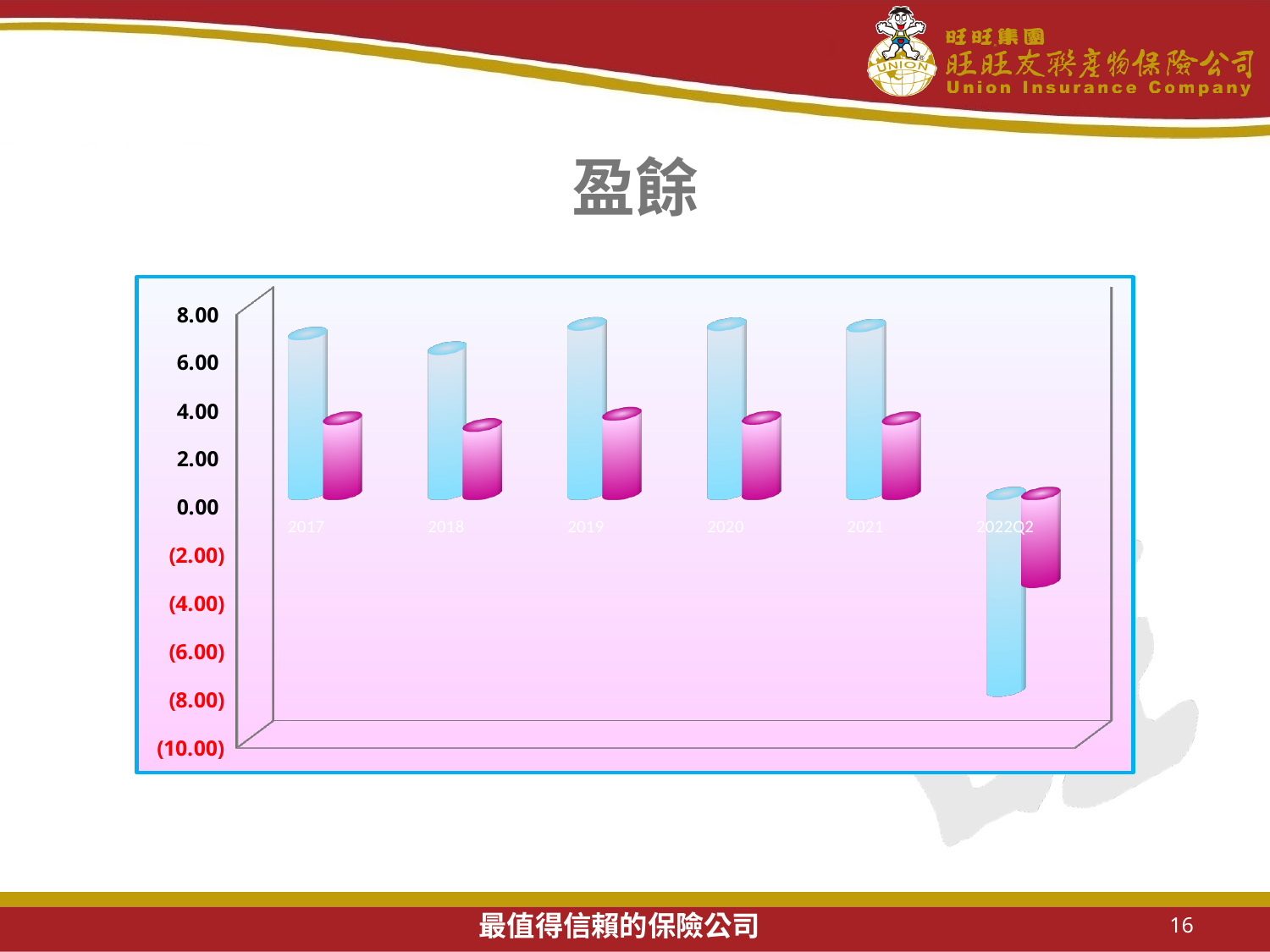
How many bars are plotted for each category in the chart? 2 What kind of chart is shown on the slide? bar chart Which category has the lowest value for the magenta series? 2022Q2 How many categories are shown on the x axis of the chart? 6 Is the magenta bar for 2022Q2 greater or less than 0.00? less Which is larger, the blue bar for 2017 or the blue bar for 2018? 2017 Is the magenta bar for 2019 greater or less than 2.00? greater Is the blue bar for 2022Q2 greater or less than (6.00)? less What is the title of the chart? 盈餘 Which is larger, the blue bar for 2020 or the magenta bar for 2020? the blue bar Which category has the lowest value for the blue series? 2022Q2